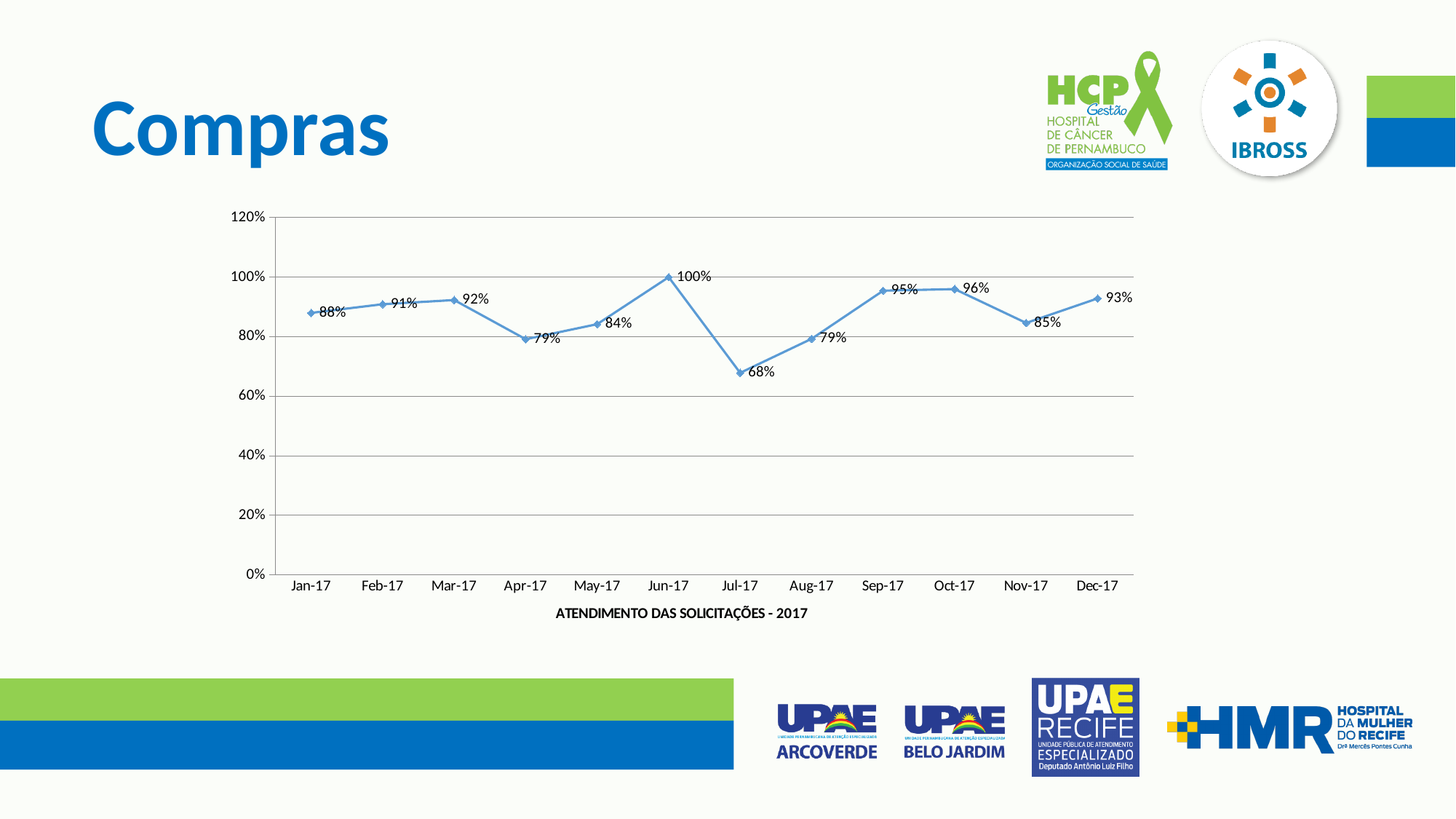
What is the value for Dec-17? 93% What is the label shown below the x axis of the chart? ATENDIMENTO DAS SOLICITAÇÕES - 2017 What is the difference between the values for Jun-17 and Jul-17? 32% What is the value for Jun-17? 100% Which month has the lowest value? Jul-17 What kind of chart is shown on the slide? line chart What is the value for Jul-17? 68% Which is larger, the value for Mar-17 or the value for Nov-17? Mar-17 Is the value for Aug-17 greater or less than 80%? less How many months are plotted on the x axis? 12 Which month has the highest value? Jun-17 Do the values rise or fall from Jul-17 to Oct-17? rise